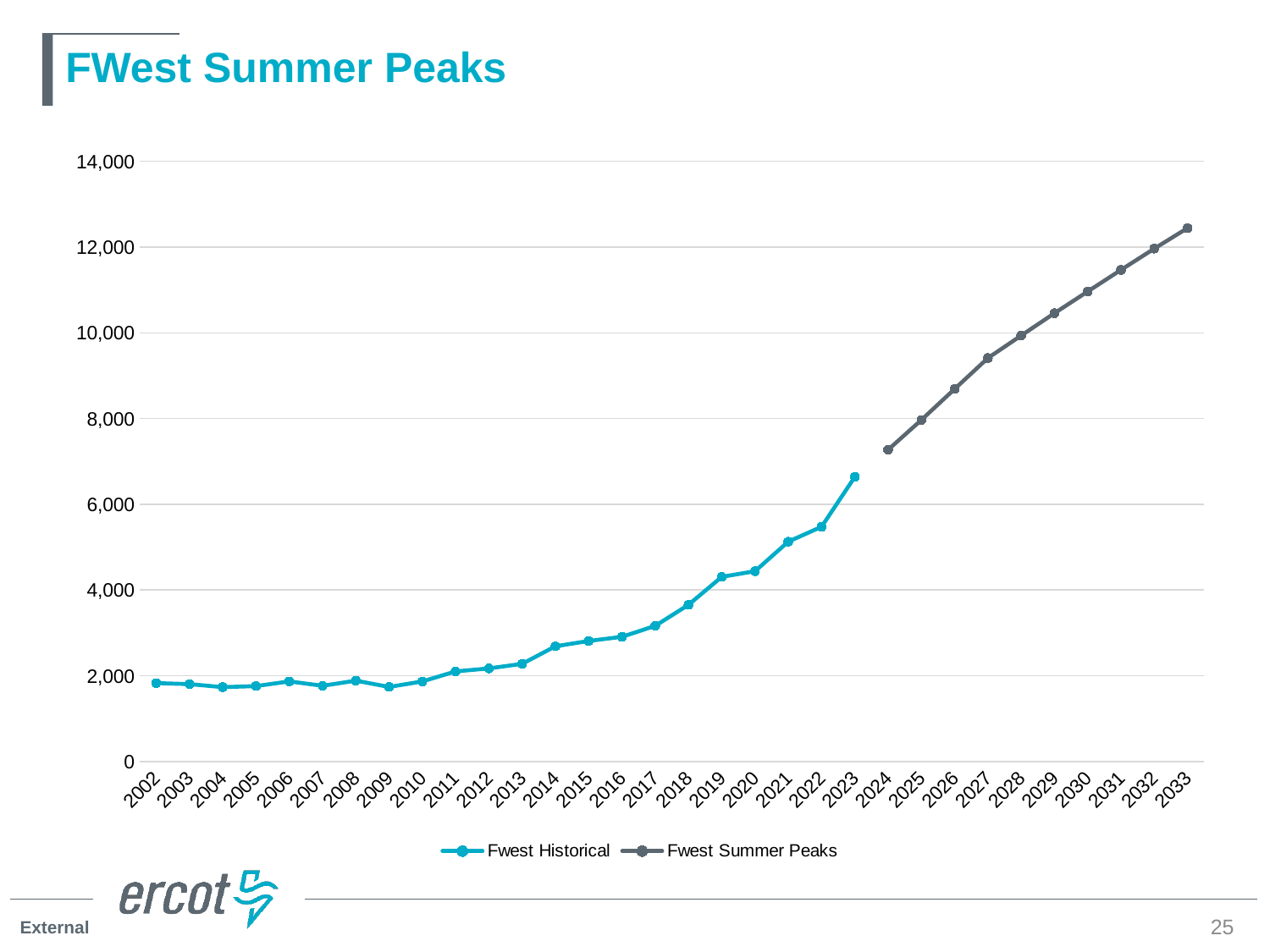
Is the Fwest Summer Peaks value for 2027 greater or less than 10,000? less Which year has the highest Fwest Summer Peaks value? 2033 Is the Fwest Summer Peaks value for 2033 greater or less than 12,000? greater Is the Fwest Historical value for 2002 greater or less than 2,000? less What are the two series named in the legend? Fwest Historical and Fwest Summer Peaks Do the Fwest Summer Peaks values rise or fall from 2024 to 2033? rise What kind of chart is shown on the slide? line chart How many series does the legend list? 2 How many years are shown on the x axis? 32 Which is larger, the Fwest Historical value for 2014 or for 2019? 2019